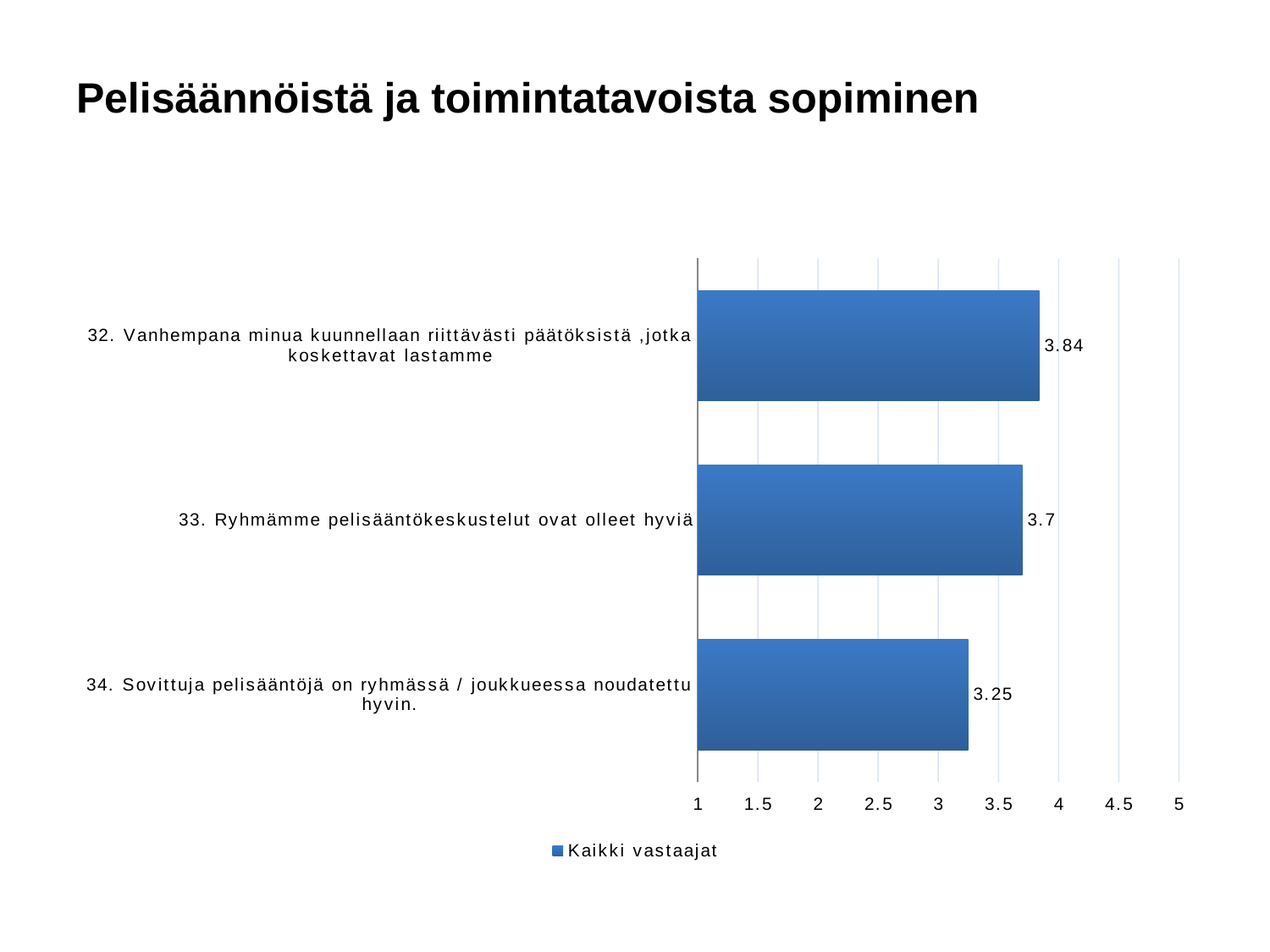
Which has a larger value, item 32 or item 33? Item 32 How many series does the legend list? 1 What kind of chart is shown on the slide? Bar chart What is the difference between the values for item 33 and item 34? 0.45 What is the difference between the values for item 32 and item 34? 0.59 What is the value for item 32 (Vanhempana minua kuunnellaan riittävästi päätöksistä, jotka koskettavat lastamme)? 3.84 How many items (bars) are shown in the chart? 3 What is the value for item 34 (Sovittuja pelisääntöjä on ryhmässä / joukkueessa noudatettu hyvin)? 3.25 Is the value for item 34 greater or less than 3.5? less What is the value for item 33 (Ryhmämme pelisääntökeskustelut ovat olleet hyviä)? 3.7 Which item has the highest value? 32. Vanhempana minua kuunnellaan riittävästi päätöksistä, jotka koskettavat lastamme Which item has the lowest value? 34. Sovittuja pelisääntöjä on ryhmässä / joukkueessa noudatettu hyvin.